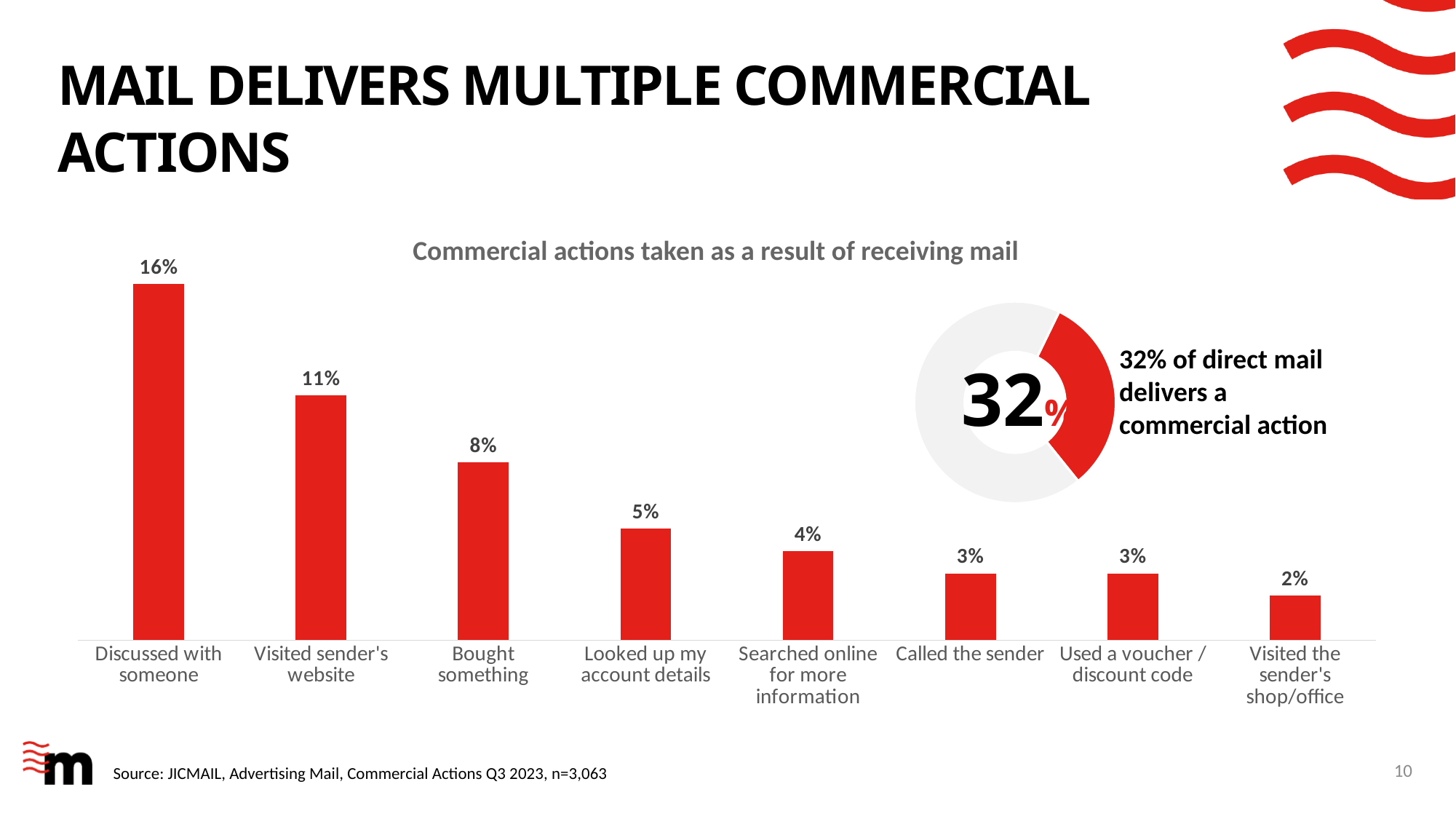
How many categories are shown in the bar chart 'Commercial actions taken as a result of receiving mail'? 8 What kind of chart is 'Commercial actions taken as a result of receiving mail'? Bar chart In the bar chart 'Commercial actions taken as a result of receiving mail', what is the difference between 'Discussed with someone' and 'Bought something'? 8% In the donut chart on the right of the slide, what share of direct mail delivers a commercial action? 32% What colour are the bars in the bar chart 'Commercial actions taken as a result of receiving mail'? Red In the bar chart 'Commercial actions taken as a result of receiving mail', what is the value for 'Used a voucher / discount code'? 3% In the bar chart 'Commercial actions taken as a result of receiving mail', which category has the highest value? Discussed with someone In the bar chart 'Commercial actions taken as a result of receiving mail', which is larger: 'Looked up my account details' or 'Called the sender'? Looked up my account details In the bar chart 'Commercial actions taken as a result of receiving mail', which category has the lowest value? Visited the sender's shop/office In the bar chart 'Commercial actions taken as a result of receiving mail', do the values rise or fall from left to right? Fall In the bar chart 'Commercial actions taken as a result of receiving mail', what is the value for 'Searched online for more information'? 4% In the bar chart 'Commercial actions taken as a result of receiving mail', what is the value for 'Visited sender's website'? 11%